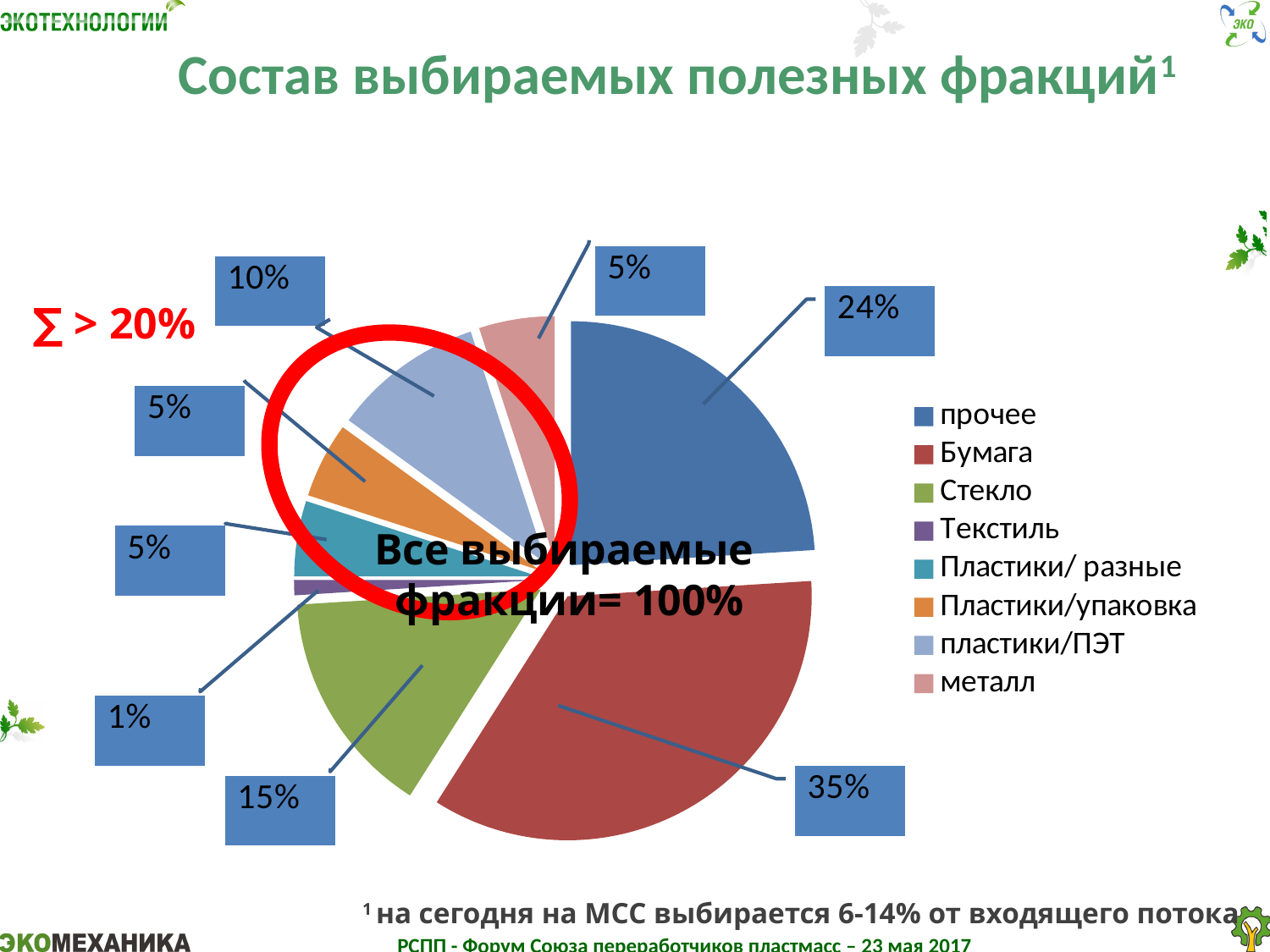
How many categories does the legend of the pie chart list? 8 What is the combined share of the three plastics categories (Пластики/ разные, Пластики/упаковка and пластики/ПЭТ)? 20% Which category has the smallest slice of the pie? Текстиль Which category has the largest slice of the pie? Бумага Which is larger, the share of Стекло or the share of пластики/ПЭТ? Стекло What share of the pie does Текстиль have? 1% What share of the pie does Стекло have? 15% What kind of chart is shown on the slide? pie chart What share of the pie does прочее have? 24% What is the difference between the shares of Бумага and прочее? 11% What share of the pie does пластики/ПЭТ have? 10% What share of the pie does Бумага have? 35%